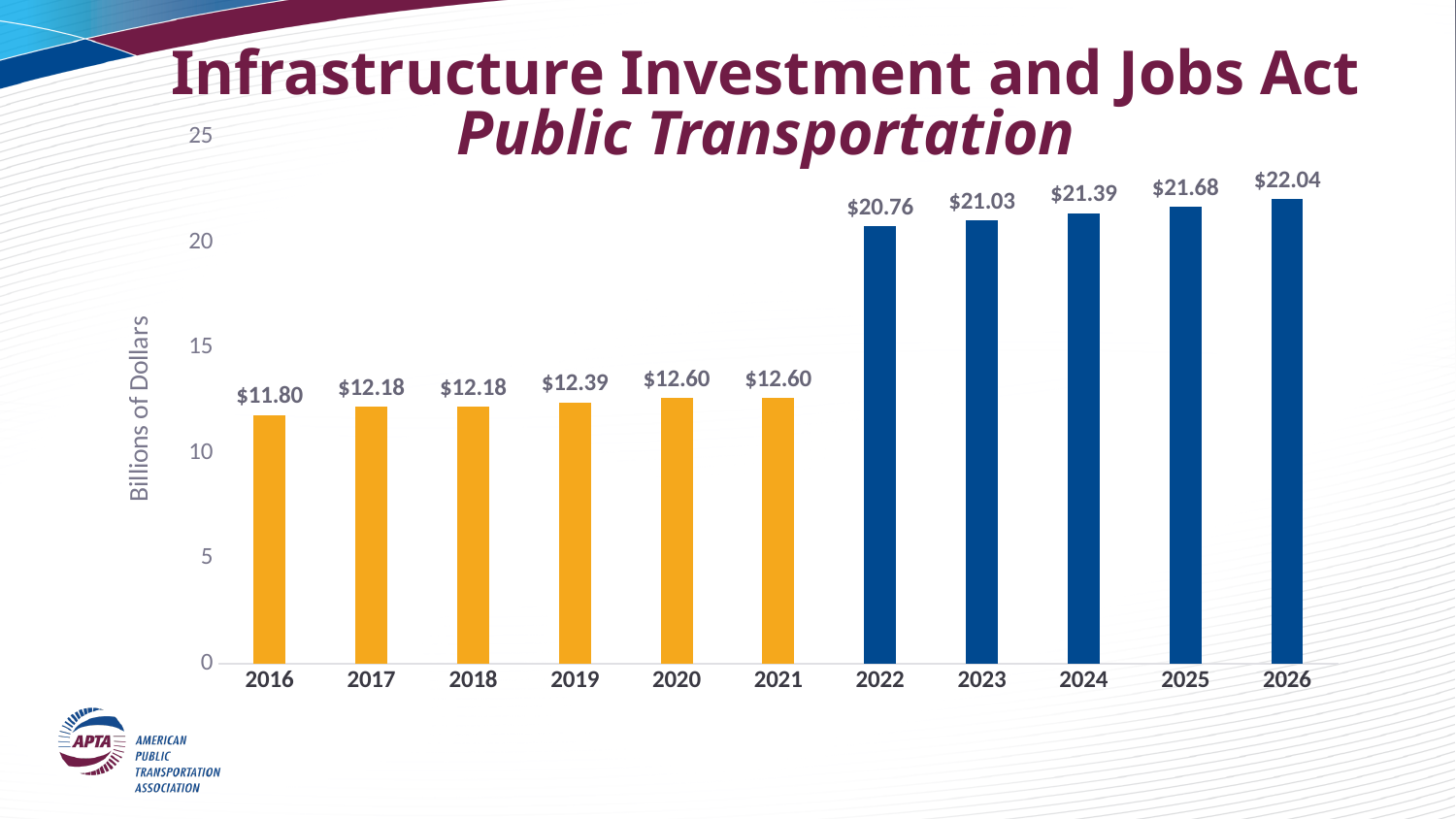
What is the label on the vertical axis? Billions of Dollars What is the value for 2016? $11.80 Which year has the lowest value? 2016 What is the value for 2026? $22.04 What kind of chart is shown? bar chart How many years are shown on the x axis? 11 Do the values rise or fall from 2016 to 2026? rise What is the value for 2022? $20.76 Which is larger, the value for 2019 or the value for 2024? 2024 Is the value for 2023 greater or less than 20? greater What is the difference between the values for 2022 and 2021? $8.16 Which year has the highest value? 2026